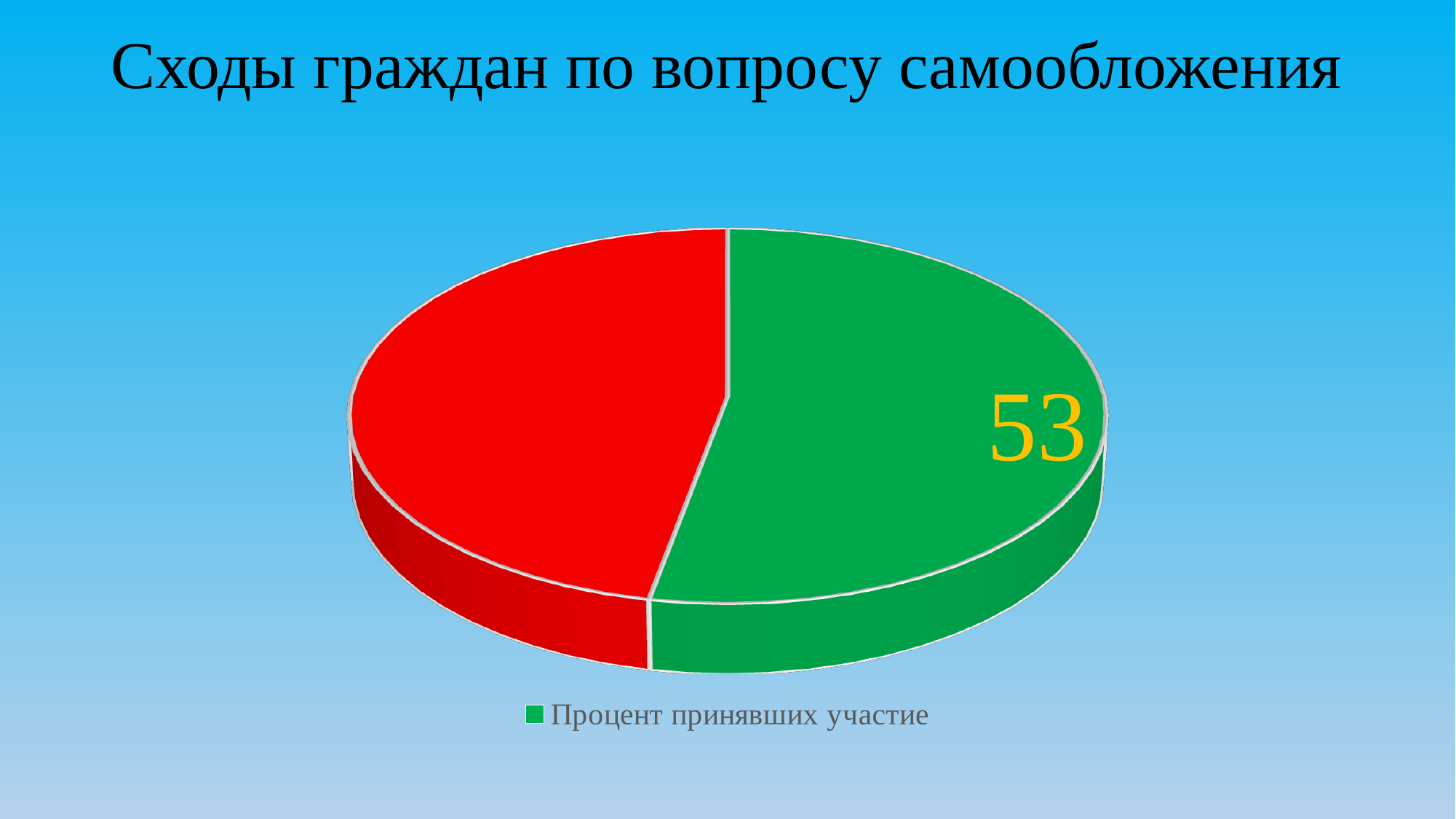
What is the title of the slide? Сходы граждан по вопросу самообложения How many slices does the pie chart have? 2 Which slice of the pie is larger, the green one or the red one? the green one What value is shown on the green slice labelled "Процент принявших участие"? 53 What colour is the slice for "Процент принявших участие"? green Which slice is the largest in the pie chart? Процент принявших участие How many entries does the legend list? 1 What kind of chart is shown on the slide? pie chart Is the value for "Процент принявших участие" greater or less than 50? greater